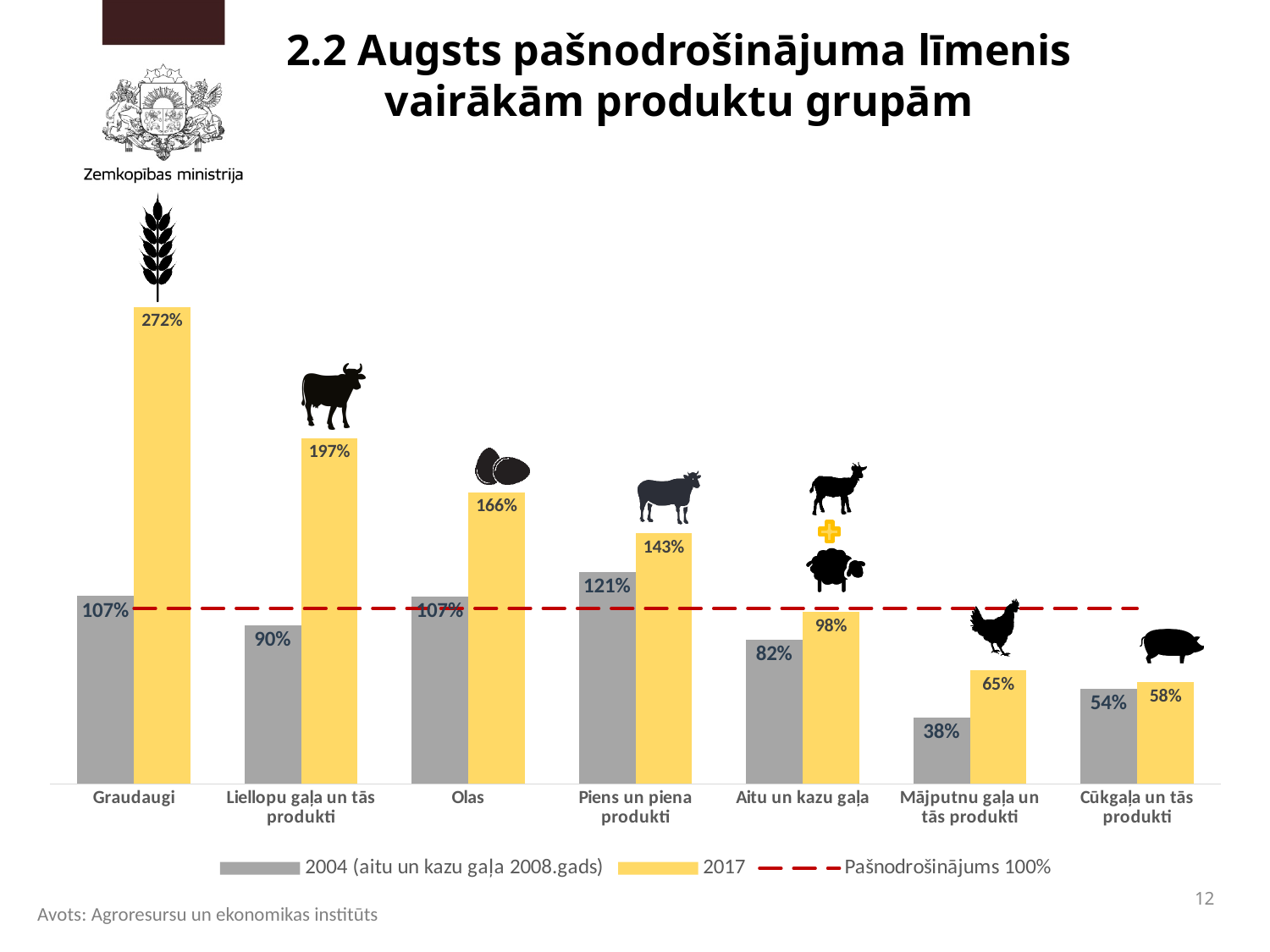
How many entries does the legend list? 3 What is the 2017 value for Aitu un kazu gaļa? 98% What is the 2004 value for Piens un piena produkti? 121% What is the difference between the 2017 and 2004 values for Liellopu gaļa un tās produkti? 107% Which category has the lowest 2004 value? Mājputnu gaļa un tās produkti Which is larger: the 2017 value for Olas or the 2017 value for Piens un piena produkti? Olas What is the 2017 value for Graudaugi? 272% What does the red dashed line in the chart represent? Pašnodrošinājums 100% What is the 2004 value for Mājputnu gaļa un tās produkti? 38% What kind of chart is shown on the slide? Bar chart Which category has the highest 2017 value? Graudaugi How many product categories are shown on the x axis? 7